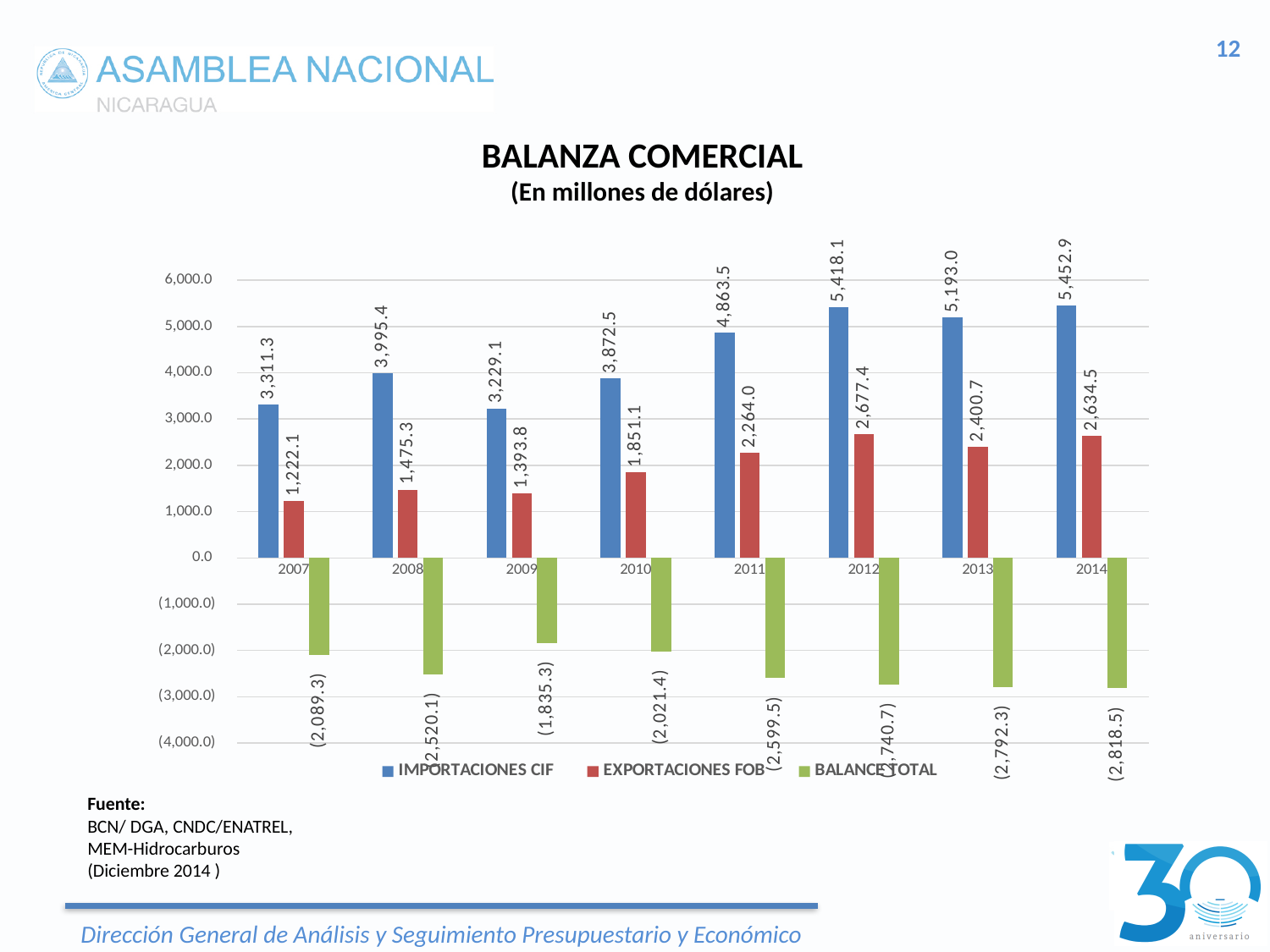
What is the difference between IMPORTACIONES CIF and EXPORTACIONES FOB in 2010? 2,021.4 How many series does the legend list? 3 In which year were IMPORTACIONES CIF highest? 2014 What is the value of EXPORTACIONES FOB for 2011? 2,264.0 What is the value of IMPORTACIONES CIF for 2014? 5,452.9 What is the BALANCE TOTAL value shown for 2009? (1,835.3) In which year were EXPORTACIONES FOB lowest? 2007 Did EXPORTACIONES FOB rise or fall from 2007 to 2012? rise Is the value of IMPORTACIONES CIF for 2009 greater or less than 3,000.0? greater What kind of chart is shown on the slide? bar chart Which year had higher EXPORTACIONES FOB, 2012 or 2014? 2012 How many years are shown on the x axis of the chart? 8